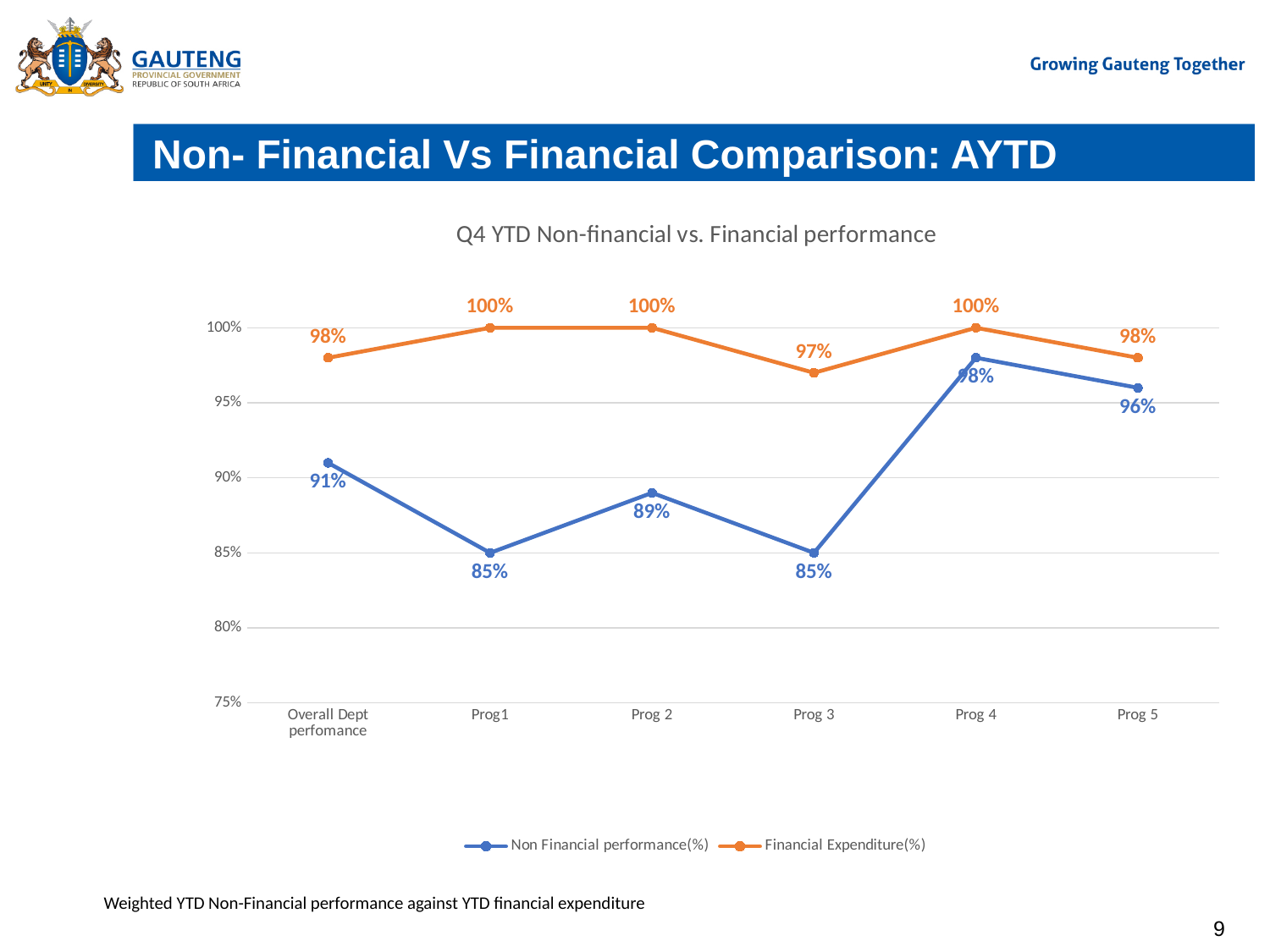
What kind of chart is shown on the slide? line chart What is the title of the chart? Q4 YTD Non-financial vs. Financial performance How many series does the chart legend list? 2 For Prog 5, which series has the larger value, Non Financial performance(%) or Financial Expenditure(%)? Financial Expenditure(%) Which category has the highest Non Financial performance(%) value? Prog 4 For Prog1, what is the difference between Financial Expenditure(%) and Non Financial performance(%)? 15 percentage points What is the Non Financial performance(%) value for Prog 2? 89% Is the Non Financial performance(%) value for Prog 4 greater or less than 95%? greater What is the Non Financial performance(%) value for Overall Dept perfomance? 91% How many categories are plotted along the x axis of the chart? 6 Which category has the lowest Financial Expenditure(%) value? Prog 3 What is the Financial Expenditure(%) value for Prog 3? 97%